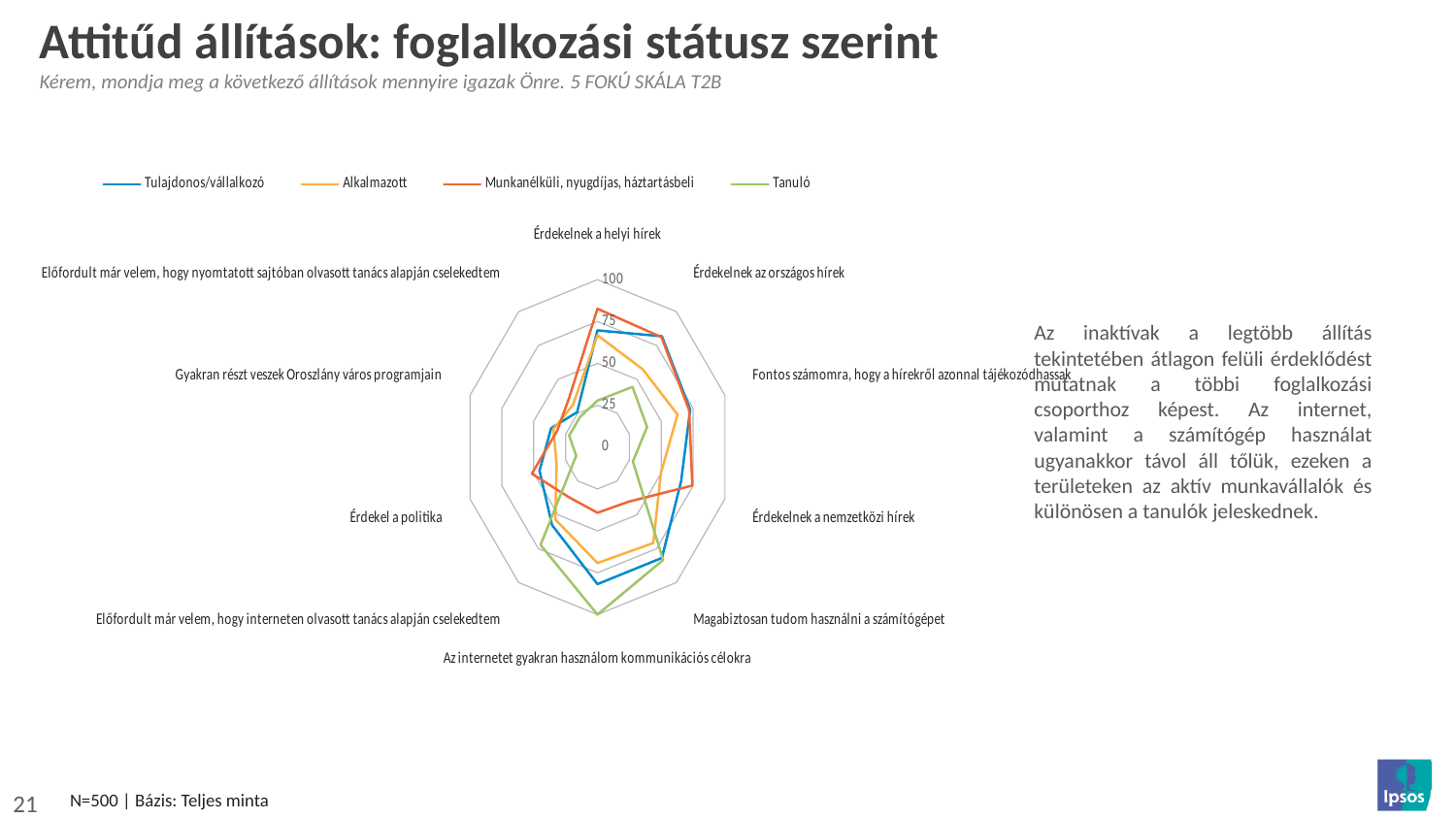
What kind of chart is shown on the slide? Radar chart How many series does the chart's legend list? 4 Is the value for Munkanélküli, nyugdíjas, háztartásbeli on 'Érdekelnek a helyi hírek' greater or less than 75? greater For 'Az internetet gyakran használom kommunikációs célokra', which series has the larger value: Tanuló or Munkanélküli, nyugdíjas, háztartásbeli? Tanuló How many statements (categories) are plotted around the radar chart? 10 Is the value for Tanuló on 'Érdekelnek a helyi hírek' greater or less than 50? less Is the value for Tanuló on 'Az internetet gyakran használom kommunikációs célokra' greater or less than 75? greater Which series is drawn in green in the chart? Tanuló What is the highest value shown on the chart's axis scale? 100 For 'Érdekelnek a helyi hírek', which series has the larger value: Munkanélküli, nyugdíjas, háztartásbeli or Tanuló? Munkanélküli, nyugdíjas, háztartásbeli